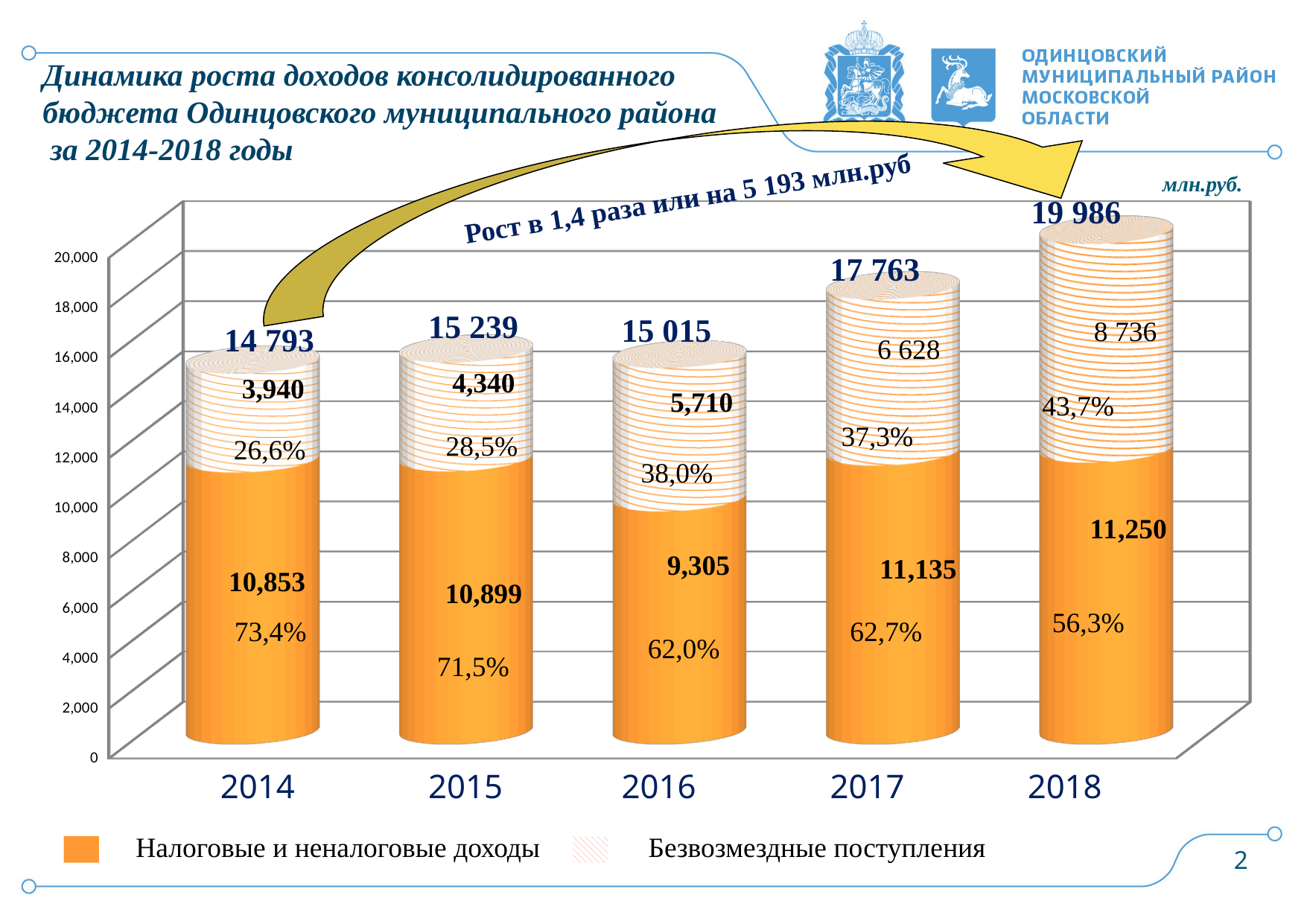
Which is larger: "Налоговые и неналоговые доходы" in 2017 or in 2018? 2018 What percentage share do "Безвозмездные поступления" make up of the 2016 total? 38,0% What is the total value shown above the bar for 2017? 17 763 What unit of measurement is indicated in the top right corner of the chart? млн.руб. What is the difference between the "Безвозмездные поступления" values for 2015 and 2014? 400 How many series does the legend list? 2 What is the value of "Налоговые и неналоговые доходы" for 2016? 9,305 How many years are shown on the x axis? 5 Which year has the highest total consolidated budget income? 2018 Which year has the lowest value of "Налоговые и неналоговые доходы"? 2016 What is the value of "Безвозмездные поступления" for 2018? 8 736 What kind of chart is shown on the slide? Stacked bar chart